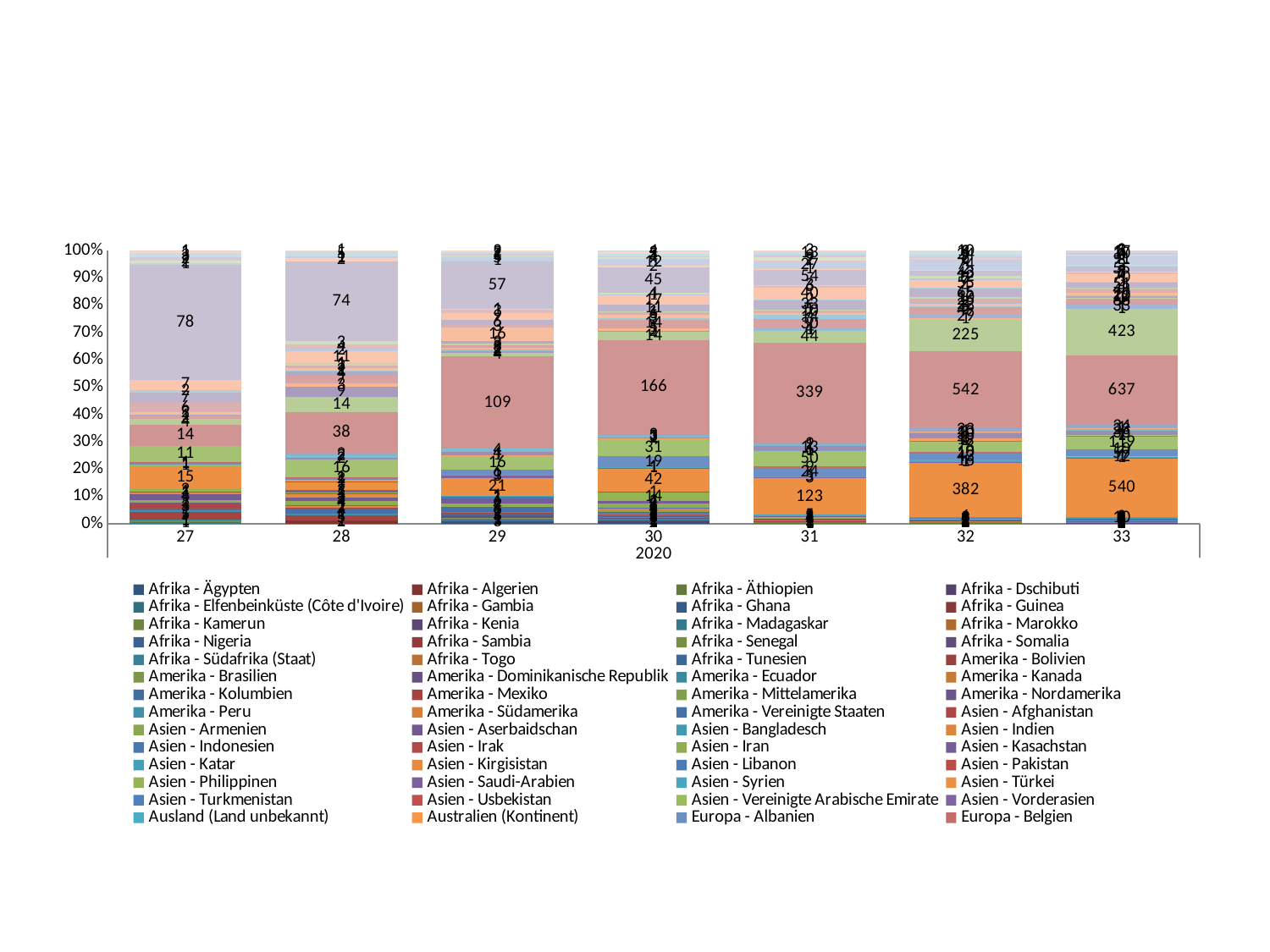
What value is printed on the green segment of the bar for category 32? 225 Do the values printed on the large red segment rise or fall from category 29 to category 33? rise What value is printed on the orange segment of the bar for category 32? 382 How many categories are shown along the x axis of the chart? 7 What is the title printed under the x axis of the chart? 2020 In the bar for category 27, is the share of the segment labeled 78 greater or less than 30%? greater What is the largest data label printed in the bar for category 33? 637 Which is larger: the orange segment value in the bar for 33 (540) or the orange segment value in the bar for 32 (382)? 540 Which category's bar contains the largest single data label in the chart? 33 What kind of chart is shown on the slide? stacked bar chart What is the largest data label printed in the bar for category 27? 78 In the bar for category 33, what is the difference between the segment labeled 637 and the segment labeled 540? 97